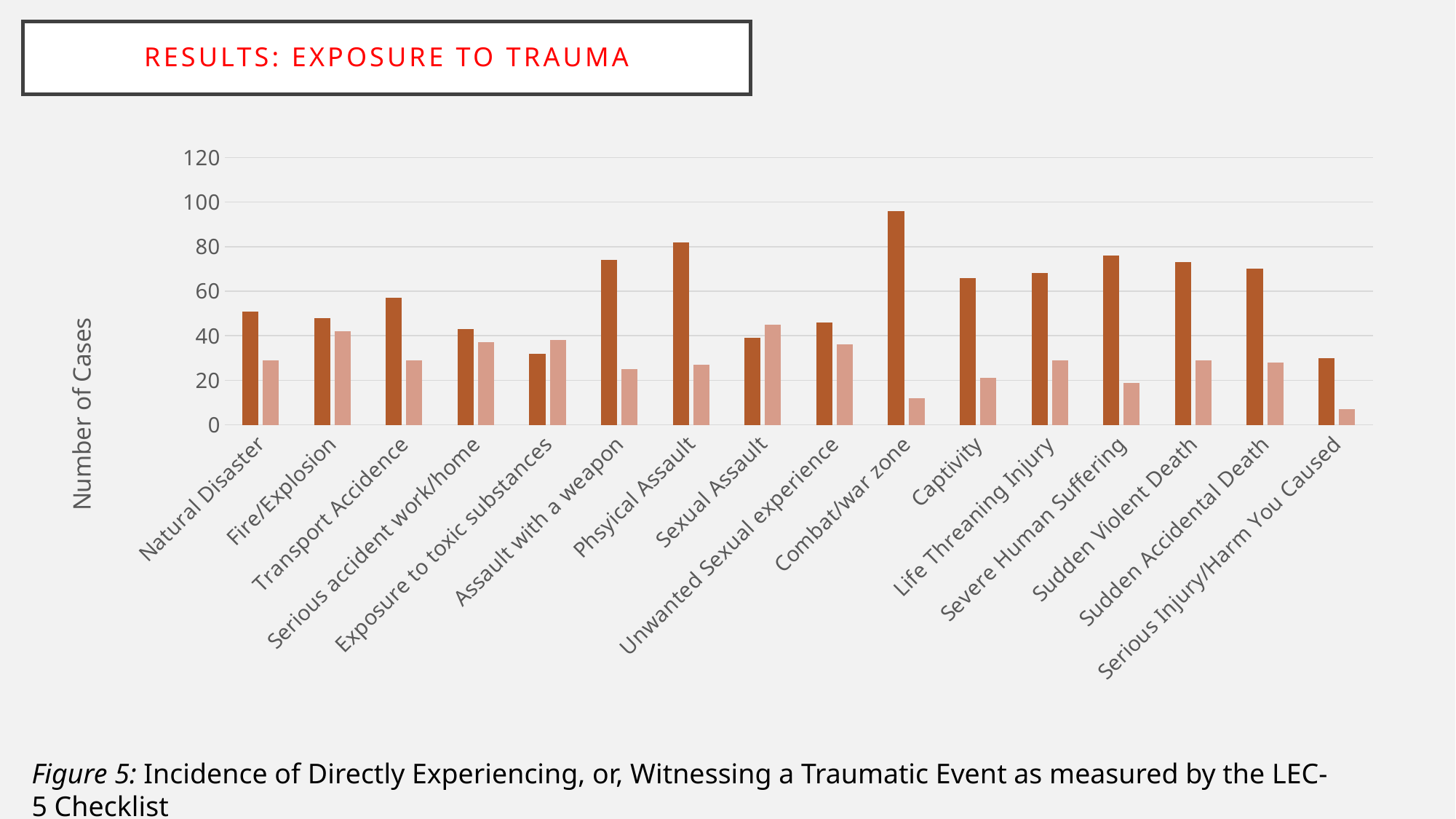
For Sexual Assault, which bar is taller, the dark brown bar or the light pink bar? the light pink bar What kind of chart is shown on the slide? bar chart How many trauma categories are shown along the x axis? 16 Is the dark brown bar for Exposure to toxic substances greater or less than 40? less Is the dark brown bar for Combat/war zone greater or less than 80? greater Is the dark brown bar for Natural Disaster greater or less than 40? greater Which category has the shortest light pink bar? Serious Injury/Harm You Caused Which dark brown bar is taller, Combat/war zone or Captivity? Combat/war zone What is the label on the vertical axis of the chart? Number of Cases Which category has the tallest dark brown bar? Combat/war zone What is the highest value shown on the vertical axis? 120